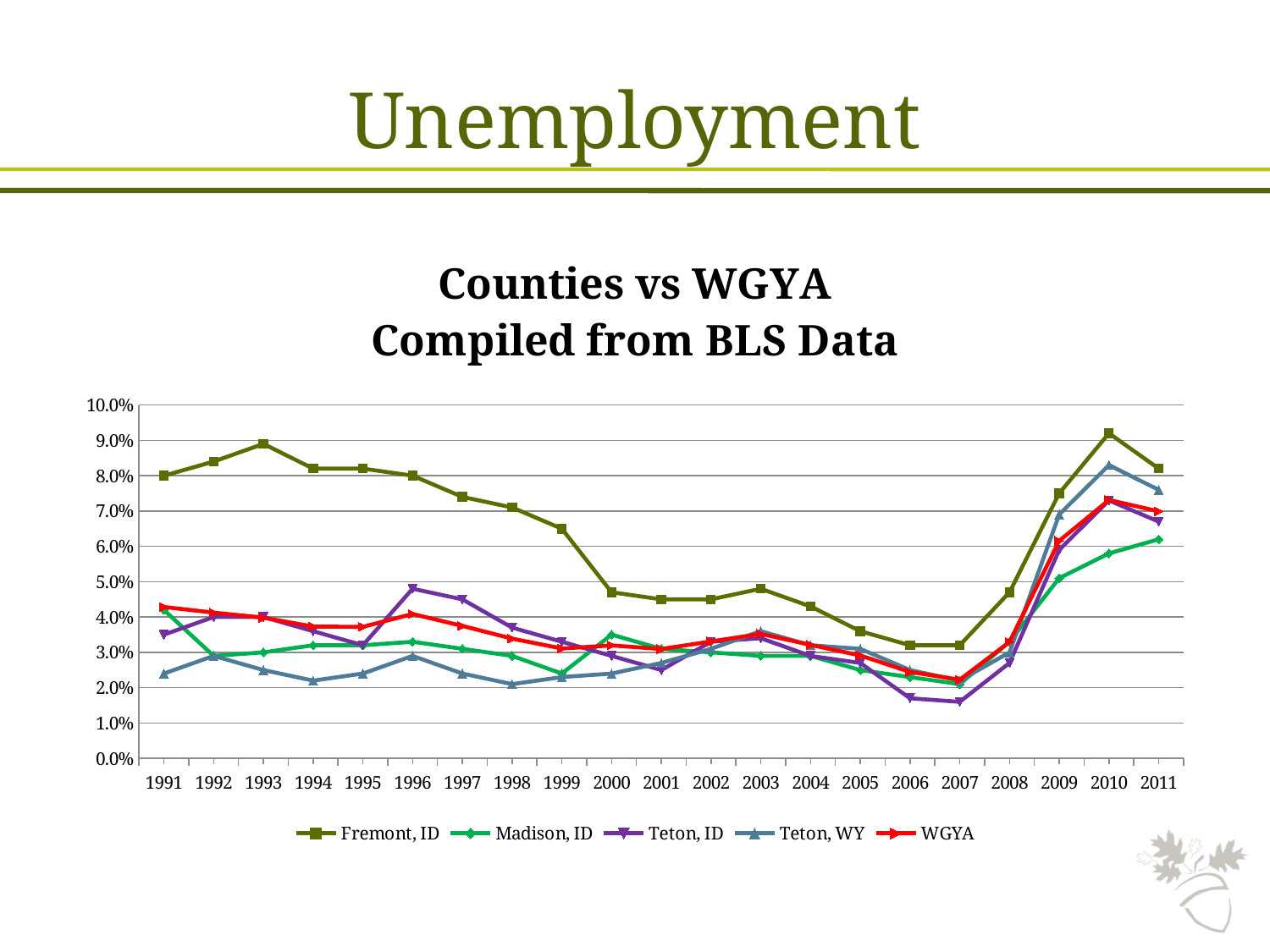
What kind of chart is shown on the slide? line chart Is the value for Fremont, ID in 2010 greater or less than 9.0%? greater In 1996, which is larger: the value for Teton, ID or the value for WGYA? Teton, ID How many series does the legend list? 5 Which series has the highest unemployment rate in 1993? Fremont, ID Is the value for Teton, WY in 1994 greater or less than 3.0%? less What is the title of the chart? Counties vs WGYA Compiled from BLS Data Does the Fremont, ID line rise or fall from 1993 to 2007? fall In 2011, which is larger: the value for Fremont, ID or the value for Madison, ID? Fremont, ID Which series has the lowest unemployment rate in 2006? Teton, ID Is the value for Teton, ID in 2007 greater or less than 2.0%? less How many years are plotted along the x axis? 21